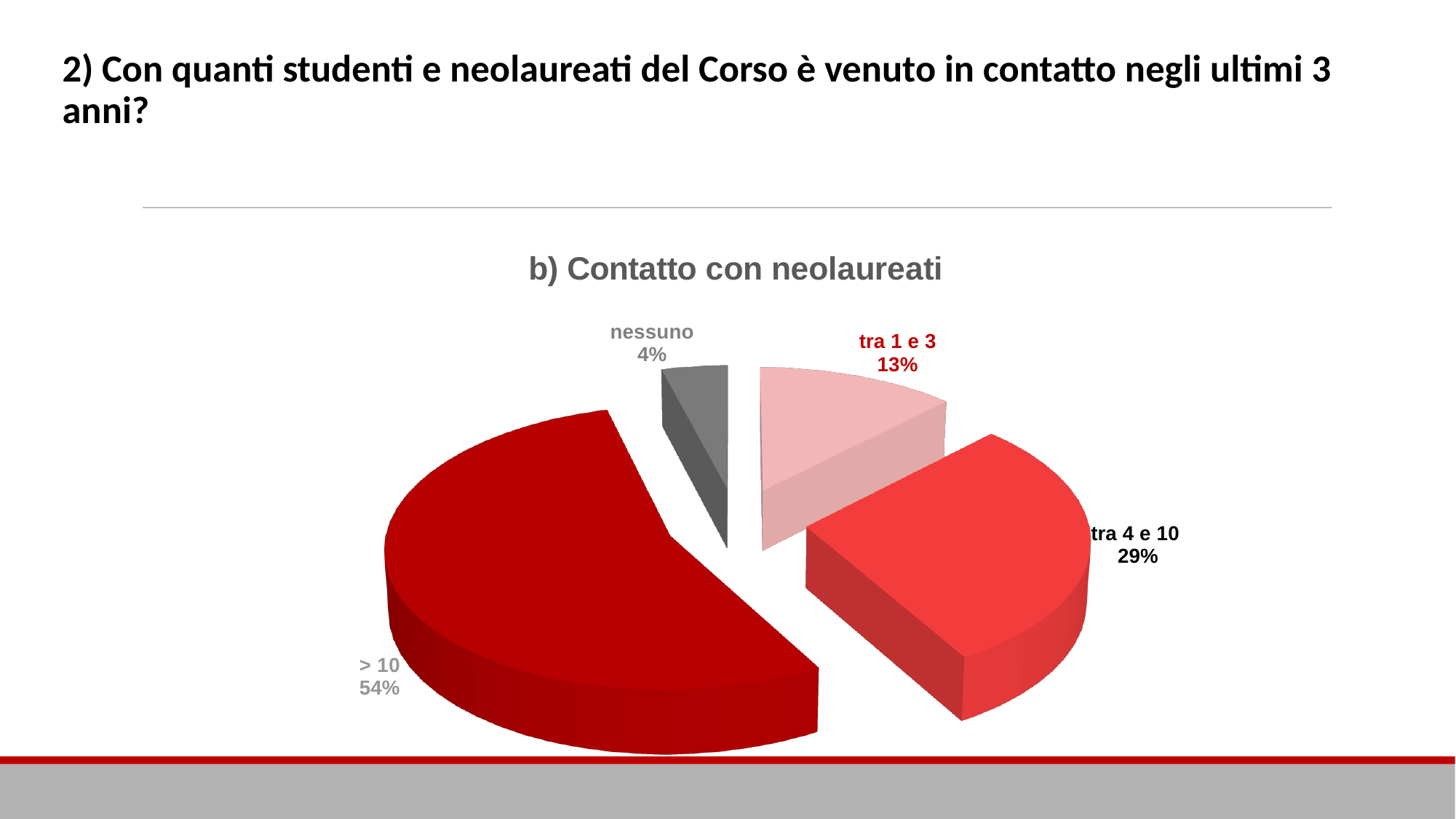
How many slices does the pie chart have? 4 Which slice is larger, "tra 1 e 3" or "tra 4 e 10"? tra 4 e 10 What colour is the "nessuno" slice? Grey What share of the pie does the "> 10" slice represent? 54% Which category has the largest slice of the pie? > 10 What is the difference in percentage points between the "> 10" slice and the "tra 4 e 10" slice? 25 What share of the pie does the "tra 1 e 3" slice represent? 13% What share of the pie does the "tra 4 e 10" slice represent? 29% What is the title of the chart? b) Contatto con neolaureati Which category has the smallest slice of the pie? nessuno What kind of chart is shown on the slide? Pie chart